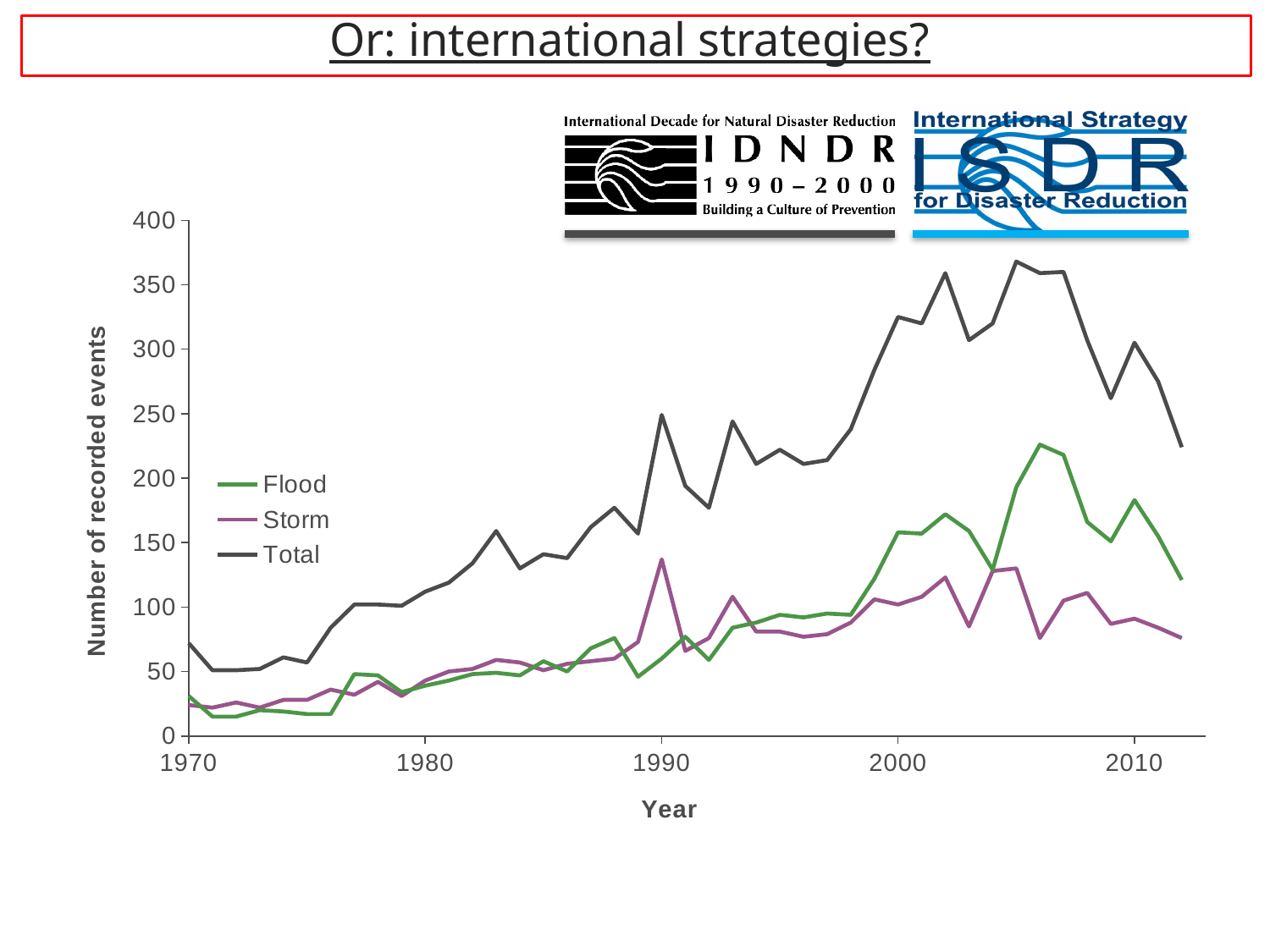
Overall, does the Total line rise or fall from 1970 to 2010? rise Is the value of the Total line in 2010 greater or less than 250? greater In 1990, which is larger, the Flood value or the Storm value? Storm How many series does the chart's legend list? 3 Is the value of the Storm line in 1990 greater or less than 100? greater What are the three series named in the chart's legend? Flood, Storm, Total In 2010, which is larger, the Flood value or the Storm value? Flood Is the value of the Total line in 1980 greater or less than 150? less What kind of chart is shown on the slide? line chart What is the label of the chart's vertical axis? Number of recorded events